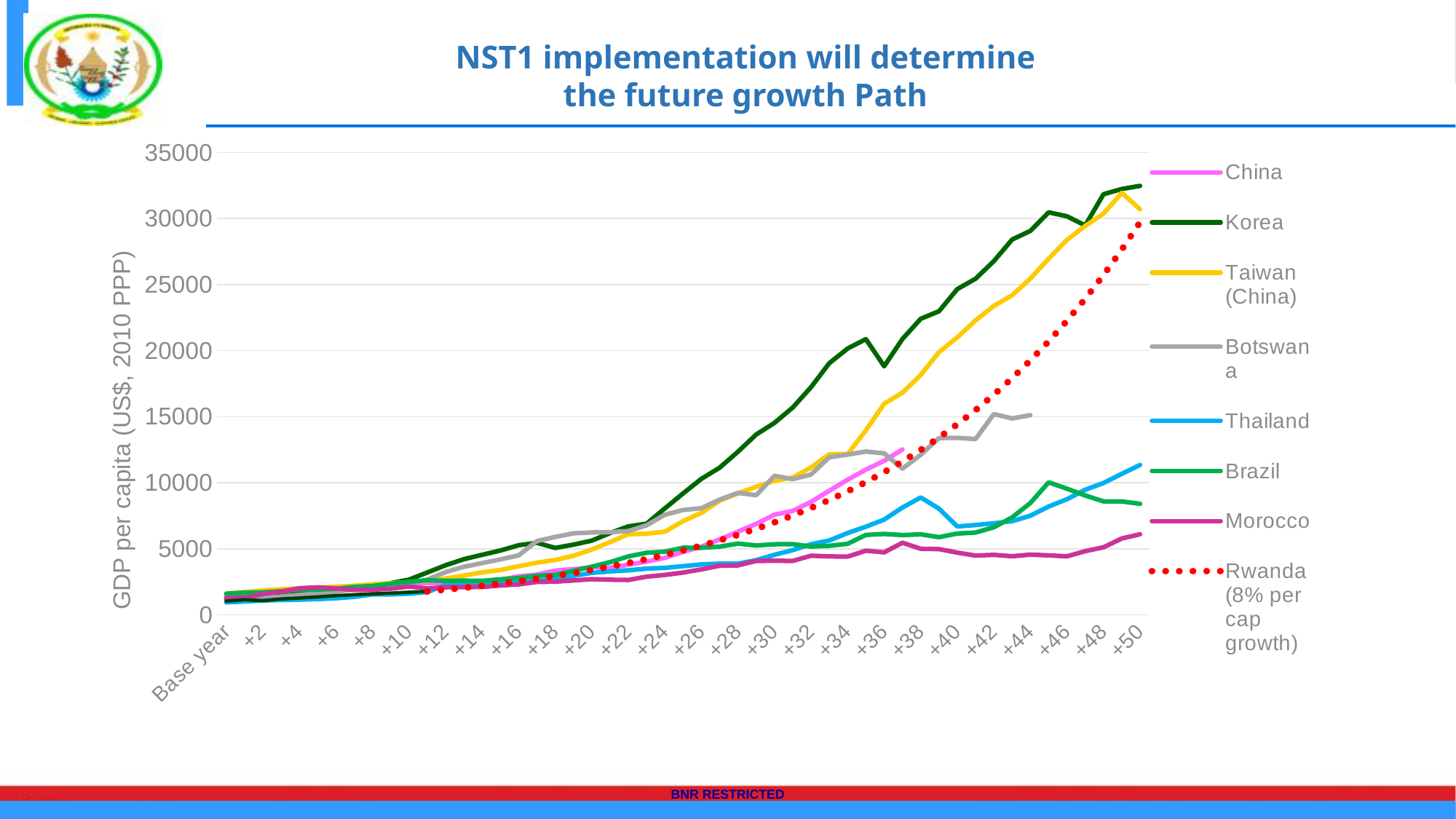
What kind of chart is shown on the slide? Line chart Is the value for Brazil at +50 greater or less than 10000? less Which series has the lowest GDP per capita at +50? Morocco Which series has the highest GDP per capita at +50? Korea At +50, which is larger: Thailand or Brazil? Thailand Does the Korea line generally rise or fall from the base year to +50? Rise How many series does the legend list? 8 Is the value for Thailand at +50 greater or less than 15000? less Is the value for Korea at +50 greater or less than 30000? greater Which series is drawn as a dotted line? Rwanda (8% per cap growth) At +44, which is larger: Korea or Botswana? Korea